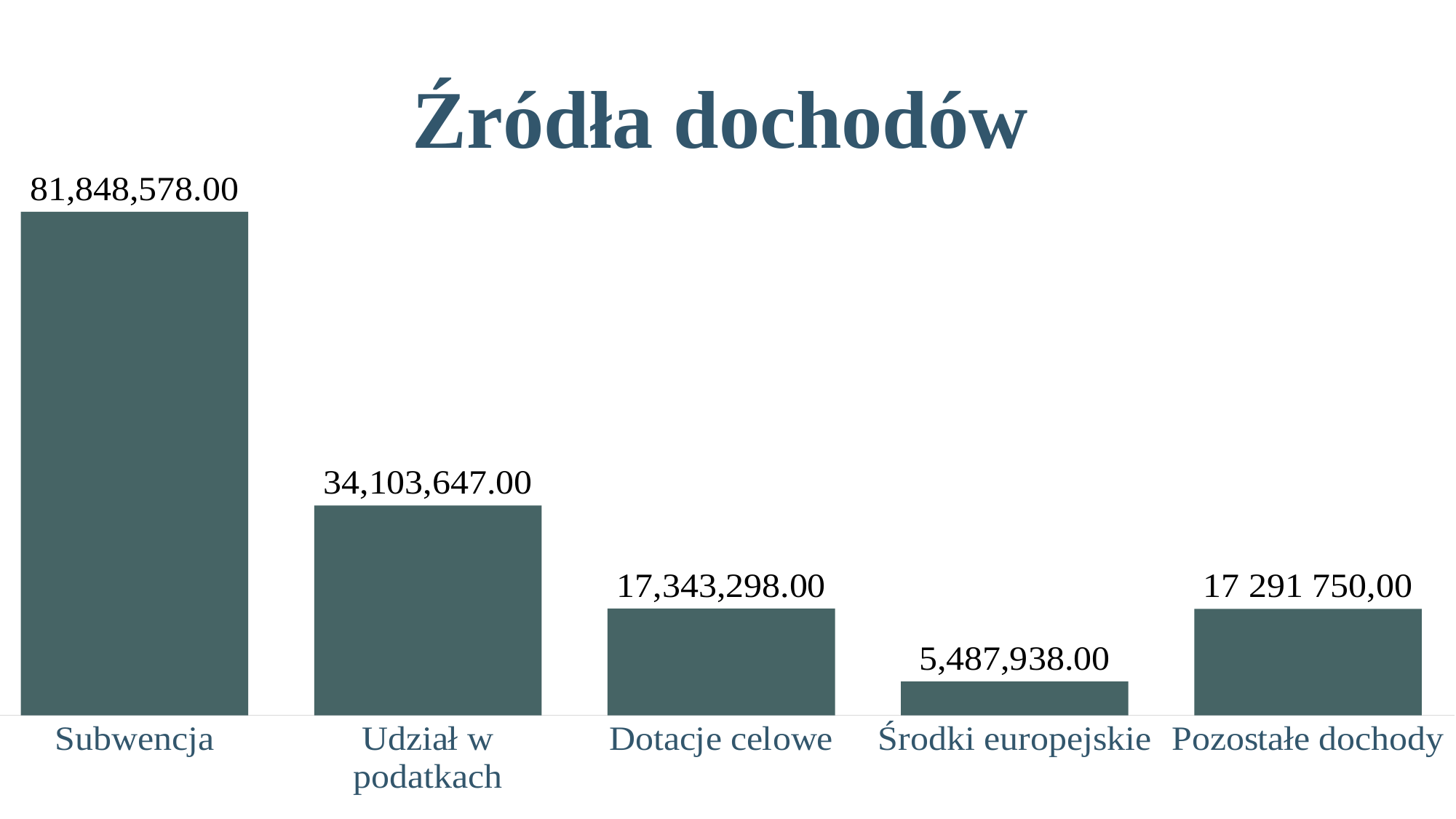
Which category has the lowest value? Środki europejskie What is the value for Środki europejskie? 5,487,938.00 How many categories are shown in the chart? 5 Which category has the highest value? Subwencja What is the difference between the values for Subwencja and Udział w podatkach? 47,744,931.00 What is the value for Dotacje celowe? 17,343,298.00 What is the value for Pozostałe dochody? 17 291 750,00 What is the value for Udział w podatkach? 34,103,647.00 What is the difference between the values for Dotacje celowe and Środki europejskie? 11,855,360.00 What type of chart is shown on the slide? Bar chart What is the value for Subwencja? 81,848,578.00 Which is larger, the value for Udział w podatkach or the value for Środki europejskie? Udział w podatkach